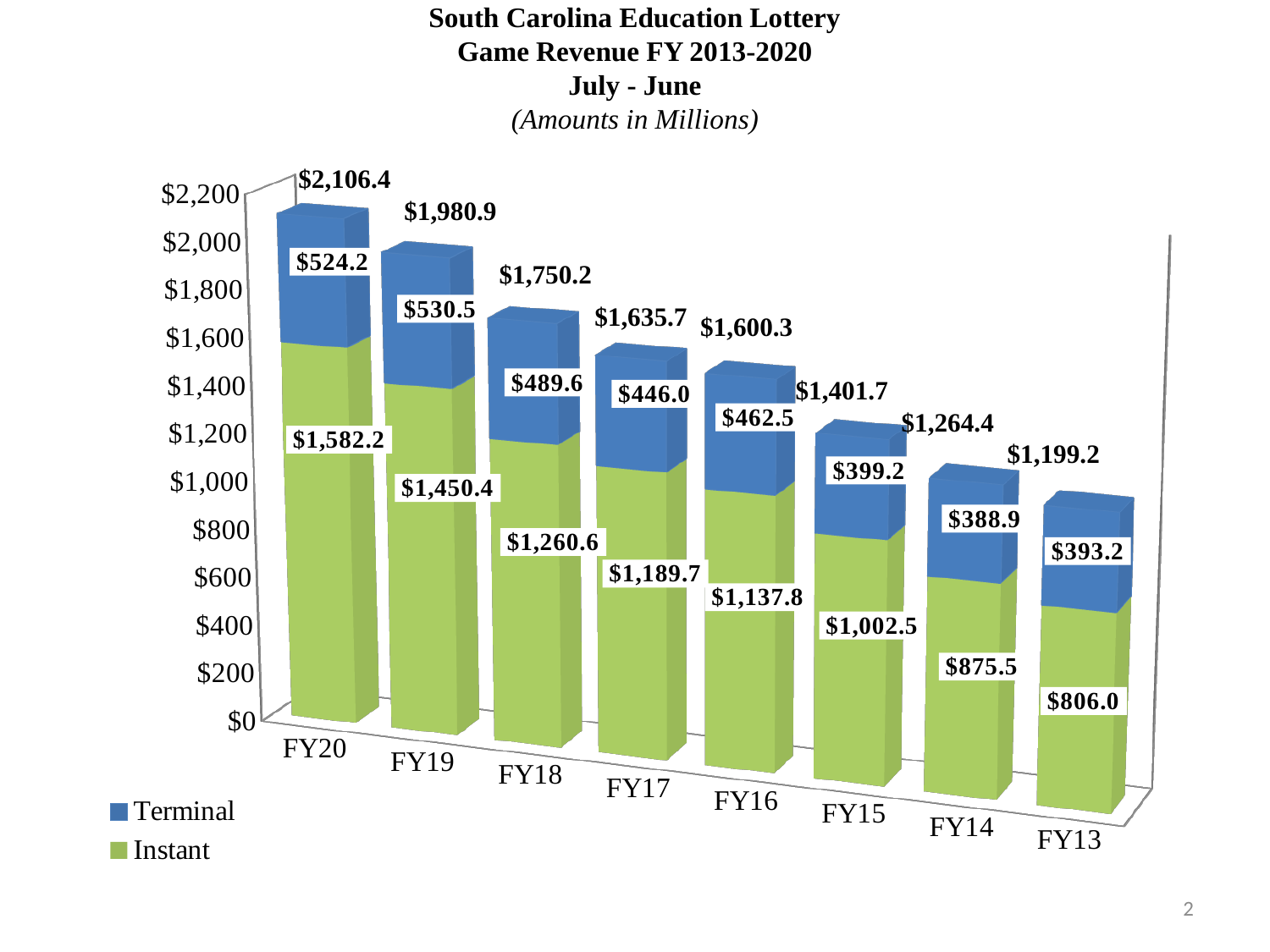
Which is larger, the Terminal revenue for FY14 or for FY13? FY13 Which fiscal year has the lowest Instant revenue? FY13 Which fiscal year has the highest Terminal revenue? FY19 What is the difference between the Instant revenue for FY20 and FY19? $131.8 How many series does the legend list? 2 Which fiscal year has the highest total game revenue? FY20 What is the total game revenue for FY18? $1,750.2 What is the Terminal revenue for FY16? $462.5 What is the Instant revenue for FY13? $806.0 What is the Instant revenue for FY20? $1,582.2 What type of chart is shown on the slide? Stacked bar chart How many fiscal years are shown on the x axis? 8